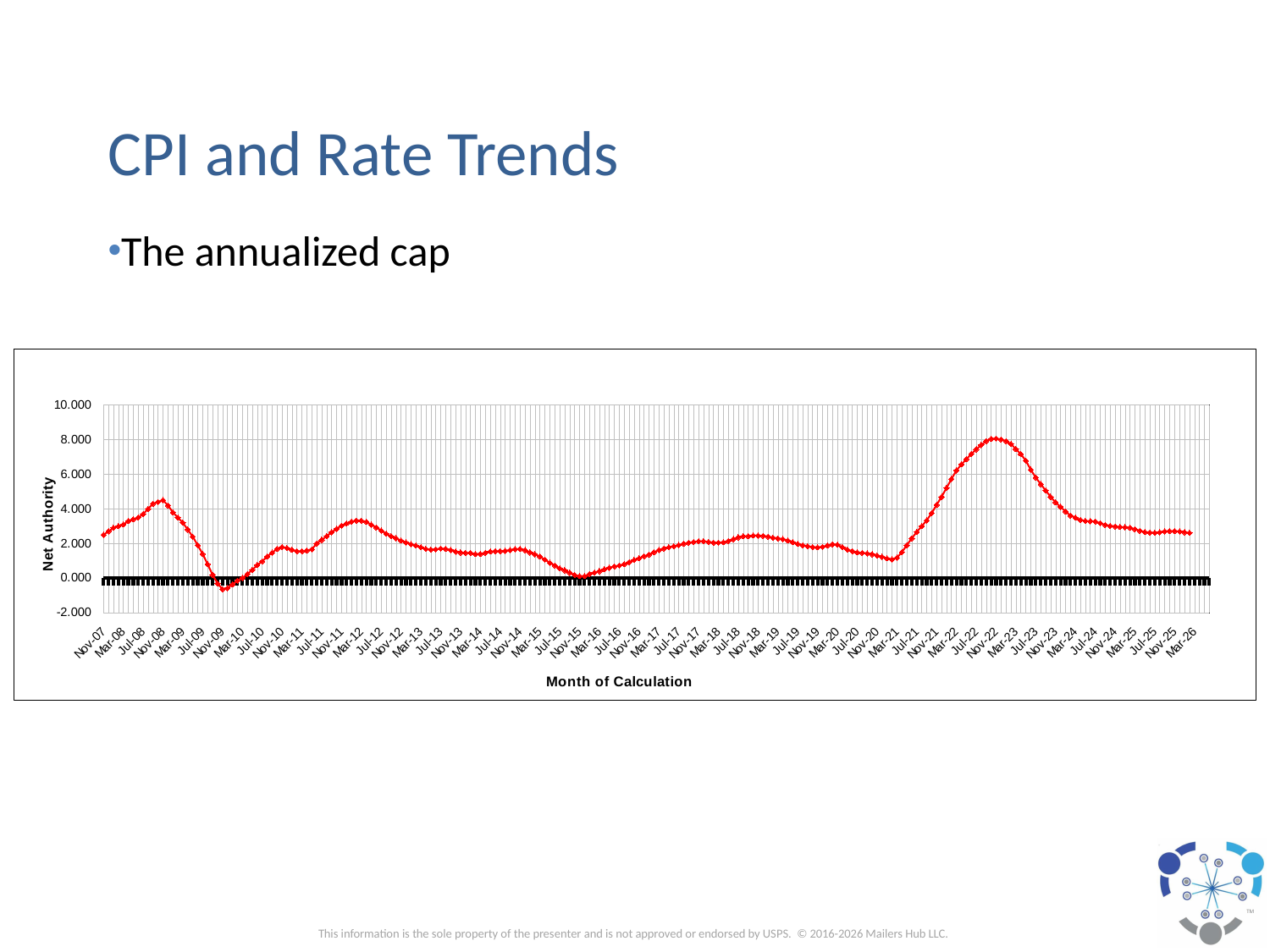
Is the value for Nov-09 greater or less than 2.000? less Is the value for Jul-23 greater or less than 4.000? greater Is the value for Nov-08 greater or less than 2.000? greater What is the title of the y axis of the chart? Net Authority Does the line rise or fall between Nov-22 and Nov-23? fall What is the title of the x axis of the chart? Month of Calculation What kind of chart is shown on the slide? line chart Around which labeled month does the line reach its highest value? Nov-22 Does the line rise or fall between Mar-21 and Nov-22? rise